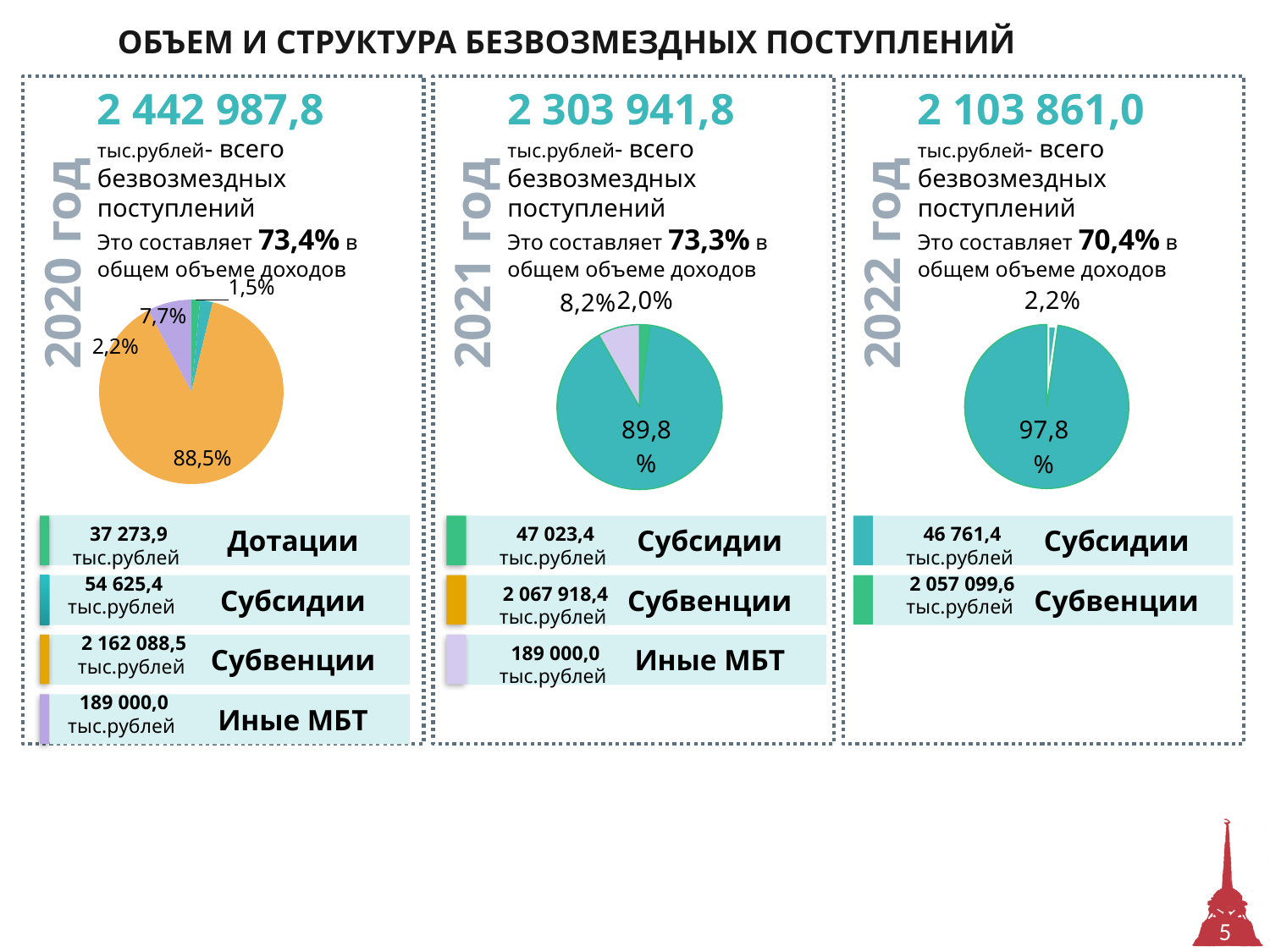
In the 2020 год chart, which category has the largest value? Субвенции In the 2021 год chart, what value is listed for Субсидии? 47 023,4 тыс.рублей In the 2021 год pie chart, what share is shown for the largest slice? 89,8% In the 2022 год pie chart, what share is shown for the largest slice? 97,8% In the 2020 год pie chart, how many slices are there? 4 In the 2022 год chart, what value is listed for Субвенции? 2 057 099,6 тыс.рублей In the 2021 год pie chart, which slice is larger: Иные МБТ (8,2%) or Субсидии (2,0%)? Иные МБТ In the 2022 год pie chart, what is the difference in percentage points between the 97,8% slice and the 2,2% slice? 95,6 In the 2020 год pie chart, what share is shown for the largest slice? 88,5% What kind of chart is used for each year on the slide? pie chart In the 2020 год chart, which category has the smallest value? Дотации In the 2020 год chart, what value is listed for Иные МБТ? 189 000,0 тыс.рублей